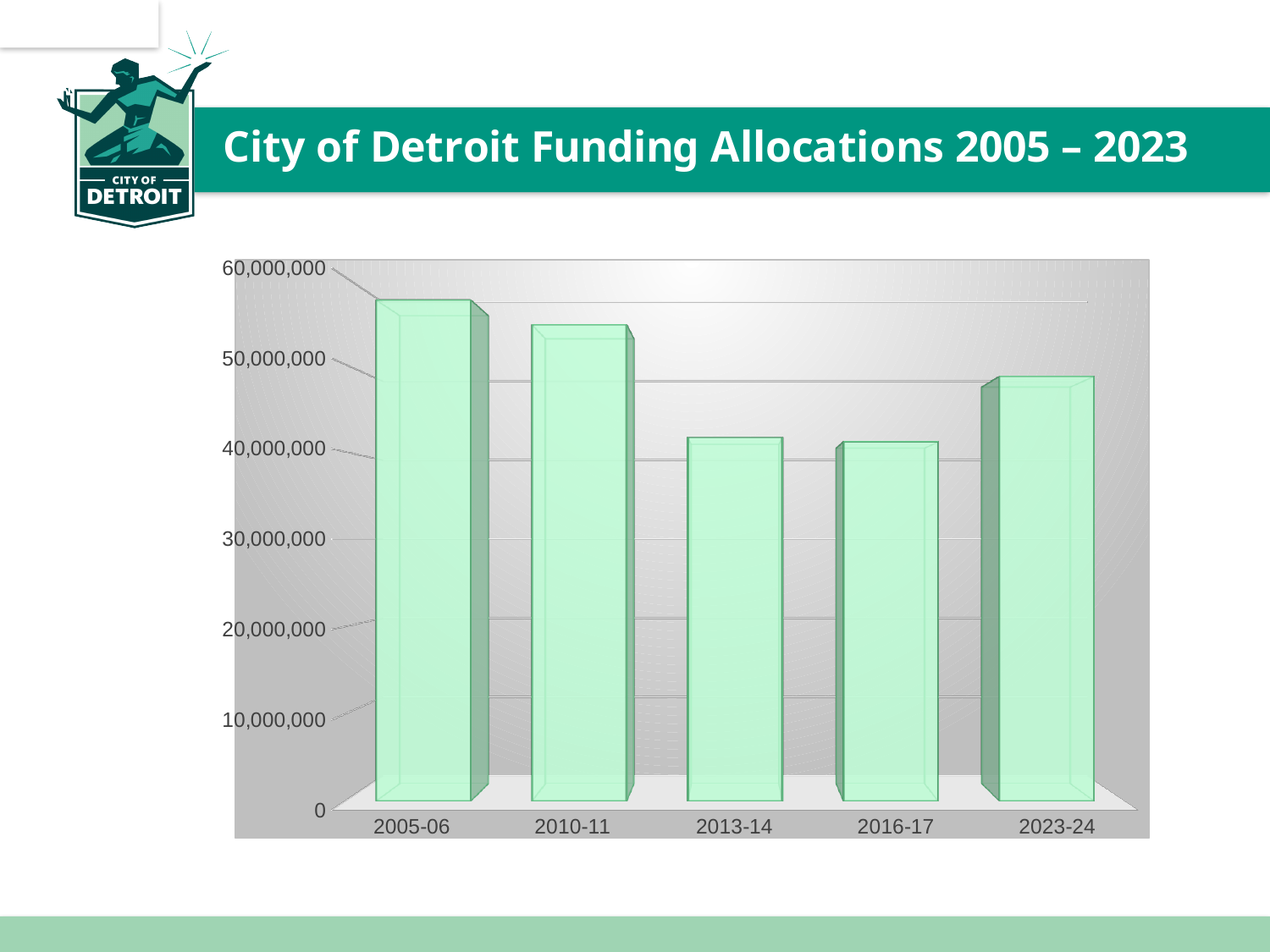
Is the value for 2016-17 greater or less than 50,000,000? less What kind of chart is shown on the slide? bar chart How many fiscal-year categories are shown on the x axis? 5 Is the value for 2013-14 greater or less than 50,000,000? less Is the value for 2005-06 greater or less than 50,000,000? greater Which is larger, the value for 2005-06 or the value for 2023-24? 2005-06 Which is larger, the value for 2010-11 or the value for 2013-14? 2010-11 Do the values rise or fall from 2005-06 through 2016-17? fall What is the title of the slide? City of Detroit Funding Allocations 2005 – 2023 Which fiscal year has the highest funding allocation? 2005-06